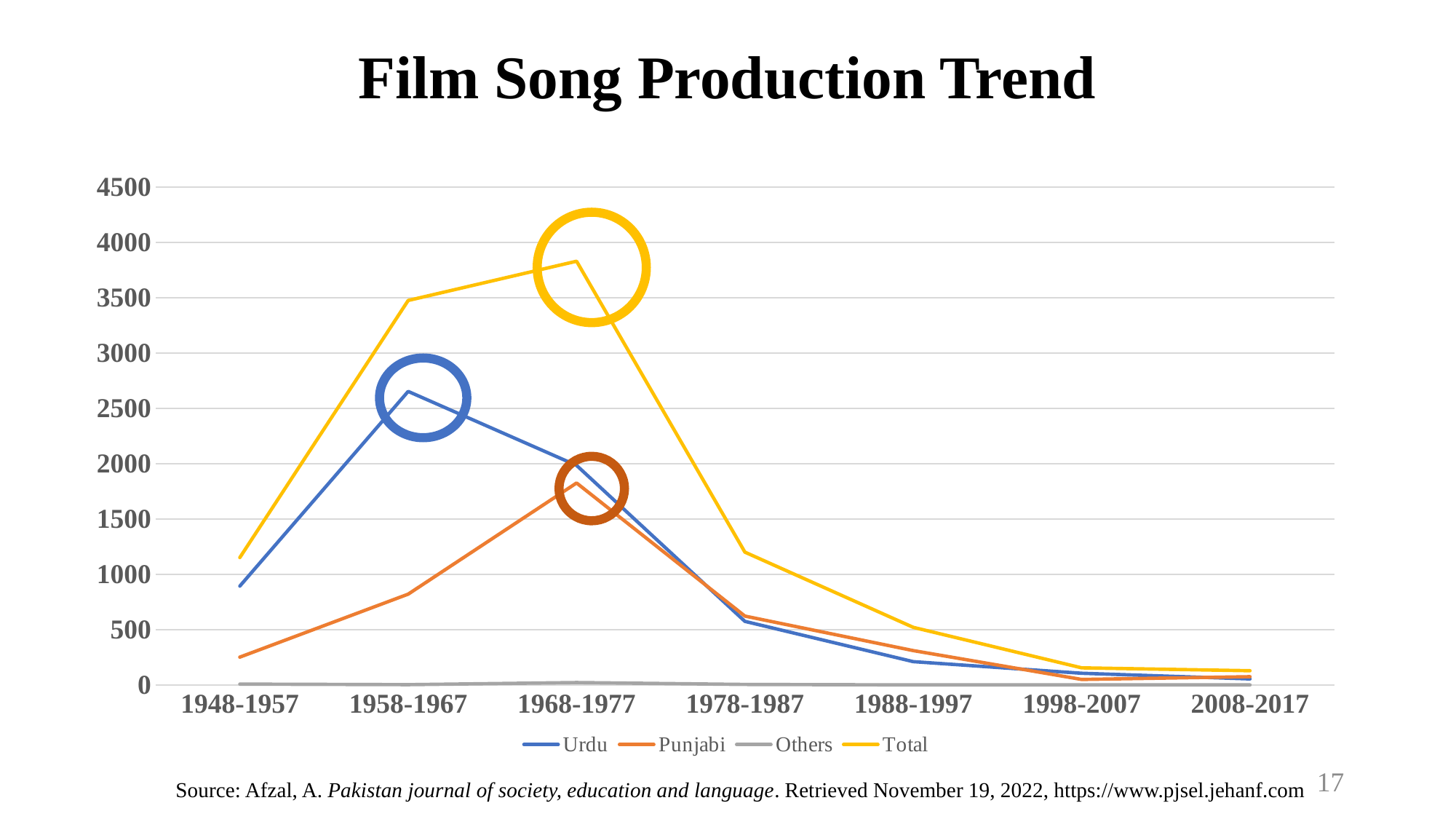
In which period does the Total series reach its highest value? 1968-1977 Is the Punjabi value for 1948-1957 greater or less than 500? less How many series does the legend list? 4 In 1958-1967, which is larger, the Urdu value or the Punjabi value? Urdu In which period does the Punjabi series reach its highest value? 1968-1977 Does the Total series rise or fall from 1968-1977 to 2008-2017? fall Is the Urdu value for 1958-1967 greater or less than 2500? greater Is the Total value for 1968-1977 greater or less than 3500? greater What is the title of the chart? Film Song Production Trend What kind of chart is shown on the slide? line chart In which period does the Urdu series reach its highest value? 1958-1967 How many time periods are shown on the x axis? 7